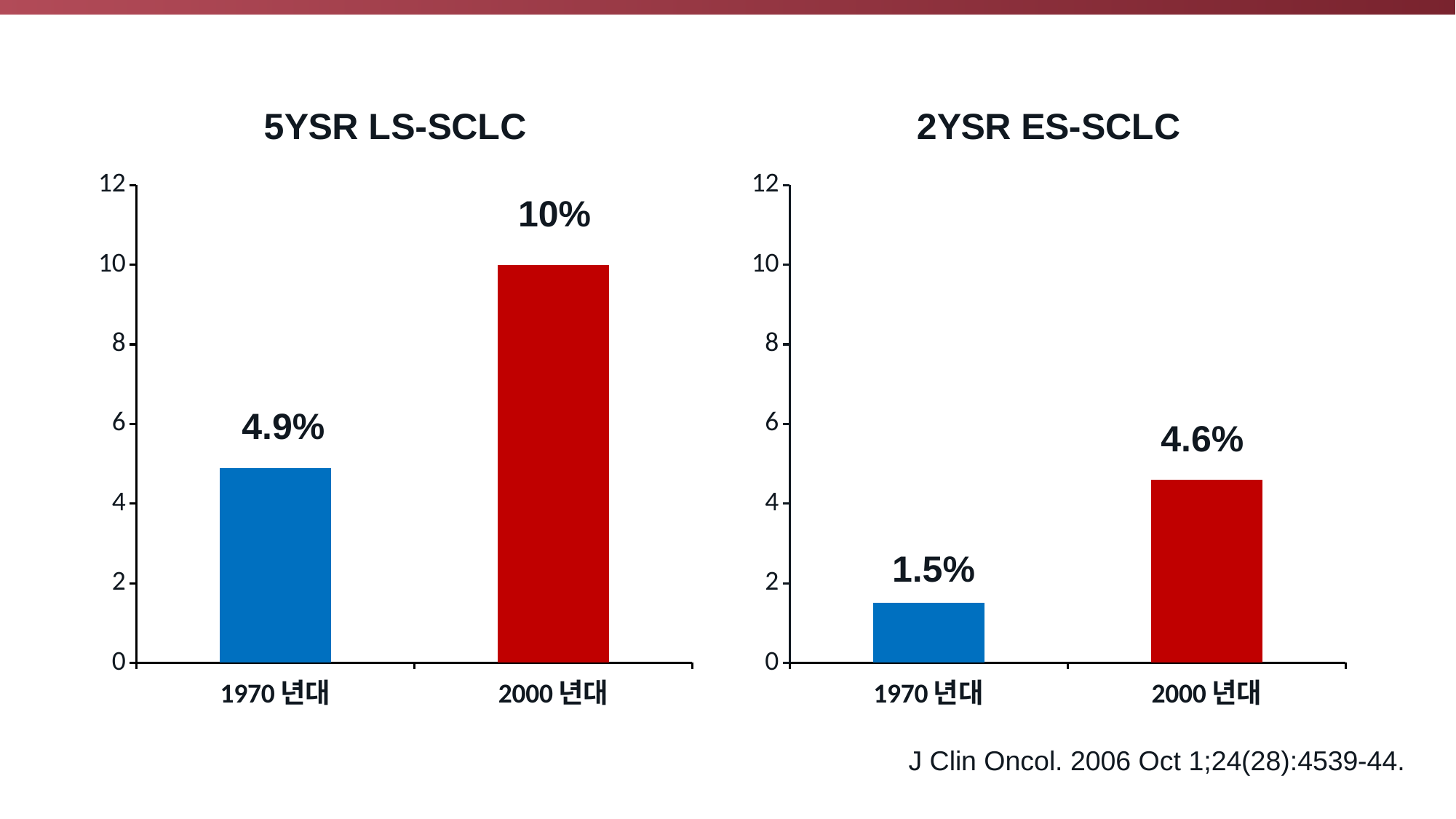
In the '5YSR LS-SCLC' chart, what is the value for 2000 년대? 10% In the '2YSR ES-SCLC' chart, which category has the lowest value? 1970 년대 In the '2YSR ES-SCLC' chart, what is the difference between the 2000 년대 and 1970 년대 values? 3.1% In the '2YSR ES-SCLC' chart, do the values rise or fall from 1970 년대 to 2000 년대? Rise In the '2YSR ES-SCLC' chart, what is the value for 2000 년대? 4.6% What kind of chart is the '2YSR ES-SCLC' chart? Bar chart In the '2YSR ES-SCLC' chart, what is the value for 1970 년대? 1.5% Which is larger: the 1970 년대 value in the '5YSR LS-SCLC' chart or the 2000 년대 value in the '2YSR ES-SCLC' chart? 1970 년대 in 5YSR LS-SCLC In the '5YSR LS-SCLC' chart, how many categories are shown on the x axis? 2 In the '5YSR LS-SCLC' chart, what is the difference between the 2000 년대 and 1970 년대 values? 5.1% In the '5YSR LS-SCLC' chart, what is the value for 1970 년대? 4.9% In the '5YSR LS-SCLC' chart, which category has the highest value? 2000 년대